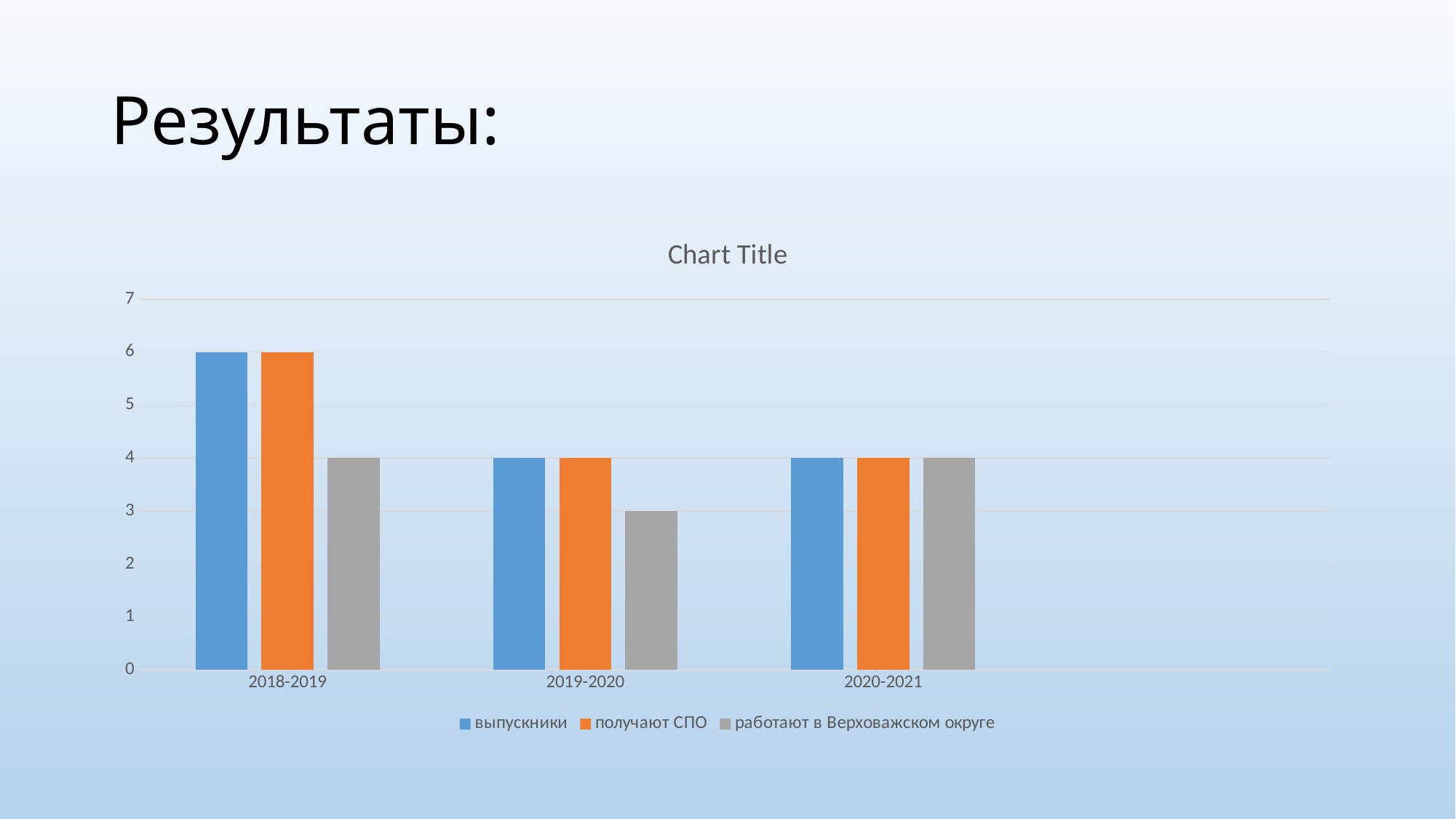
In which year is the value for работают в Верховажском округе lowest? 2019-2020 What is the title shown above the chart? Chart Title What kind of chart is shown on the slide? bar chart What is the difference between выпускники and работают в Верховажском округе in 2018-2019? 2 Does the value for выпускники rise or fall from 2018-2019 to 2019-2020? fall What is the value for работают в Верховажском округе in 2019-2020? 3 How many categories are shown on the x axis? 3 How many series does the legend list? 3 What is the value for выпускники in 2018-2019? 6 Which is larger in 2019-2020: получают СПО or работают в Верховажском округе? получают СПО What is the value for получают СПО in 2020-2021? 4 In which year is the value for выпускники highest? 2018-2019